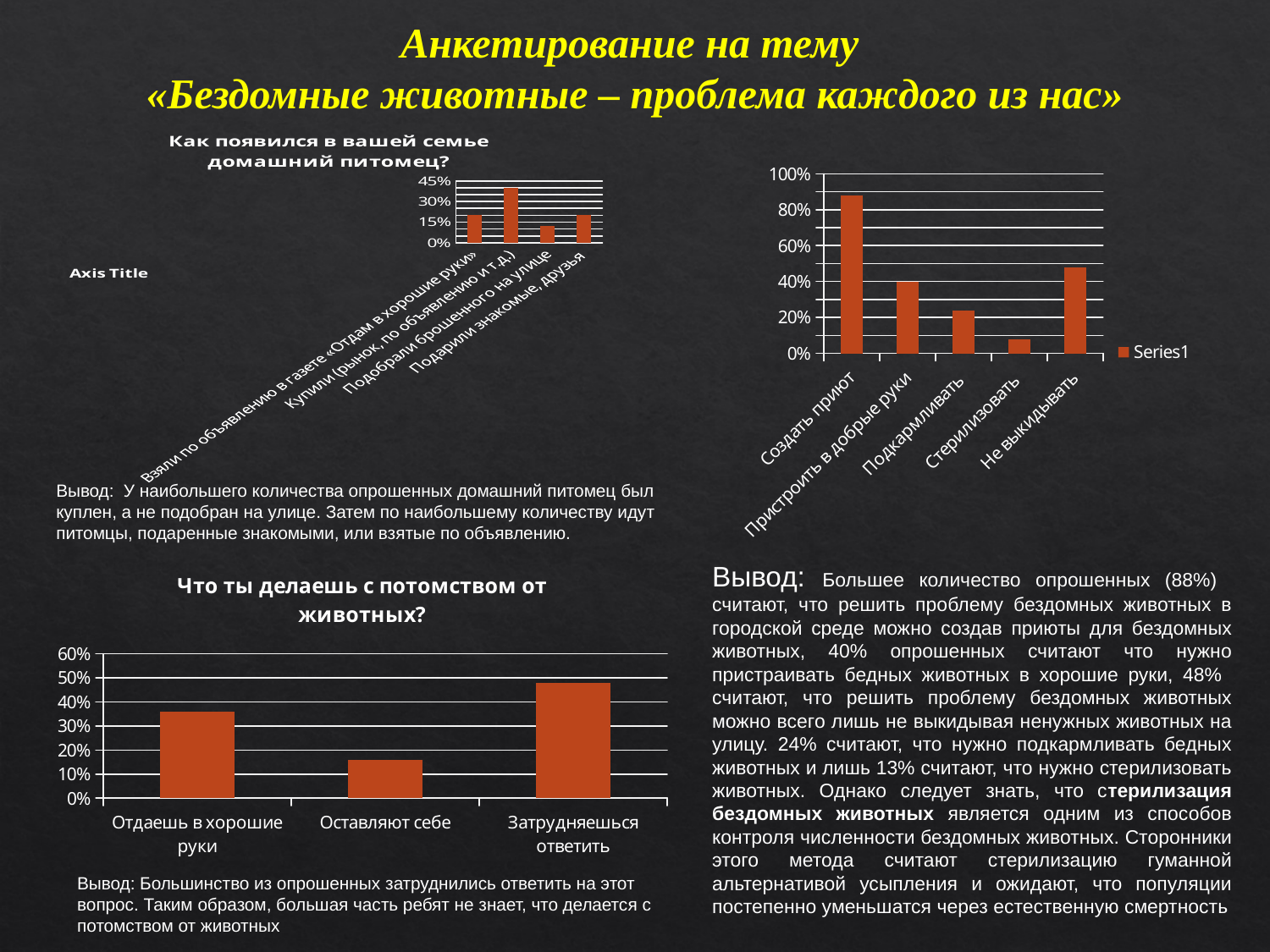
In the chart titled «Что ты делаешь с потомством от животных?», is the value for «Оставляют себе» greater or less than 20%? less In the chart titled «Что ты делаешь с потомством от животных?», which category has the lowest value? Оставляют себе In the chart on the right side of the slide, which is larger: the value for «Не выкидывать» or the value for «Подкармливать»? Не выкидывать In the chart titled «Что ты делаешь с потомством от животных?», is the value for «Отдаешь в хорошие руки» greater or less than 30%? greater How many categories are shown in the chart titled «Что ты делаешь с потомством от животных?»? 3 In the chart on the right side of the slide (with categories «Создать приют», «Пристроить в добрые руки», etc.), which category has the highest value? Создать приют What type of chart is the one titled «Что ты делаешь с потомством от животных?»? bar chart How many series does the legend list in the chart on the right side of the slide? 1 In the chart titled «Что ты делаешь с потомством от животных?», which category has the highest value? Затрудняешься ответить In the chart on the right side of the slide, is the value for «Создать приют» greater or less than 80%? greater In the chart titled «Как появился в вашей семье домашний питомец?», which category has the highest value? Купили (рынок, по объявлению и т.д.) In the chart on the right side of the slide (with categories «Создать приют», «Пристроить в добрые руки», etc.), which category has the lowest value? Стерилизовать